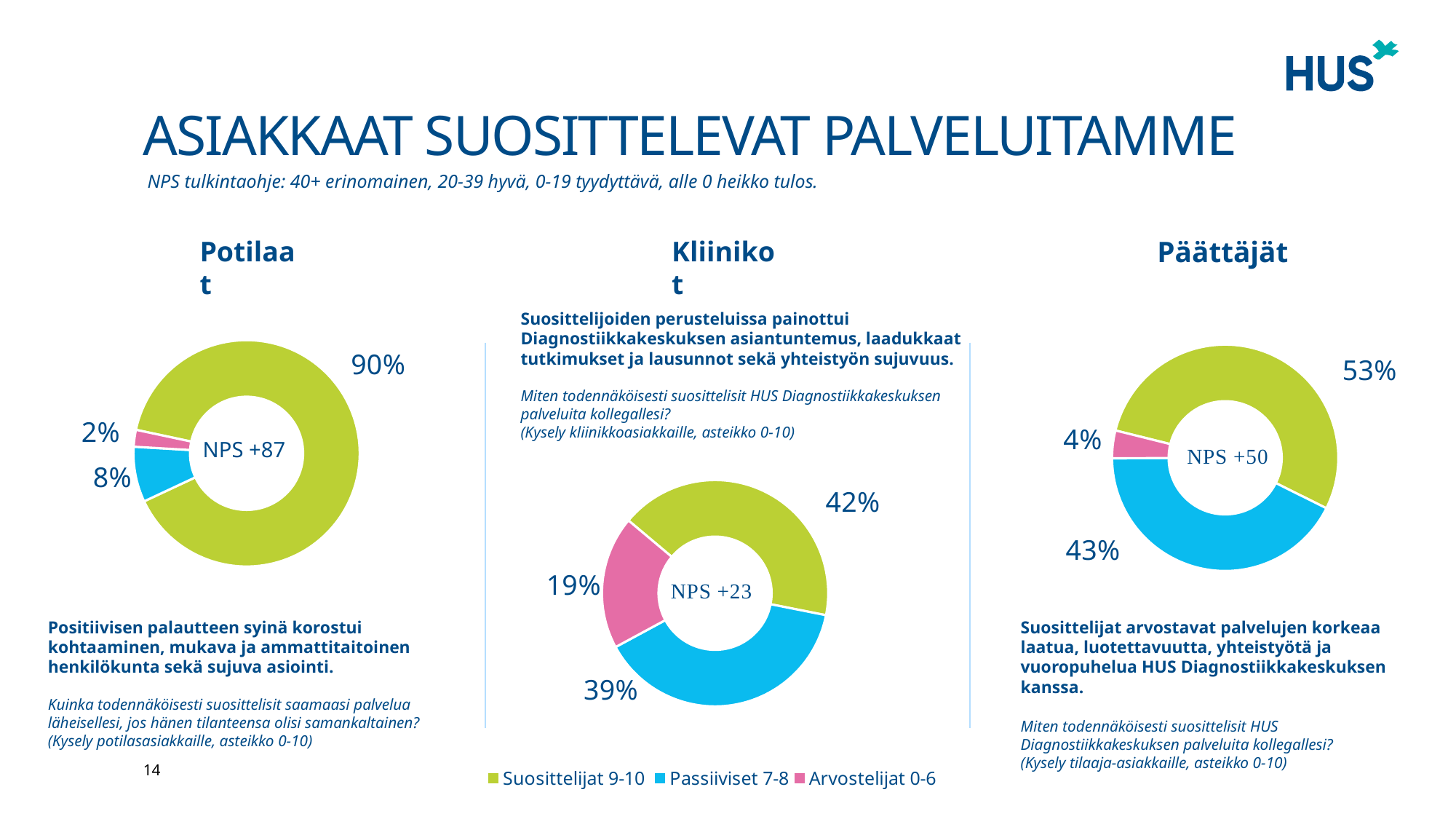
How many categories does the legend at the bottom of the slide list? 3 What NPS value is shown in the centre of the Kliinikot chart? NPS +23 What kind of chart is used for the Potilaat, Kliinikot and Päättäjät data? Donut (pie) chart In the Päättäjät chart, which category has the smallest share? Arvostelijat 0-6 In the Potilaat chart, what share is labelled for Suosittelijat 9-10? 90% In the Kliinikot chart, which category has the largest share? Suosittelijat 9-10 What NPS value is shown in the centre of the Potilaat chart? NPS +87 In the Kliinikot chart, what share is labelled for Passiiviset 7-8? 39% In the Potilaat chart, what share is labelled for Arvostelijat 0-6? 2% In the Päättäjät chart, what share is labelled for Suosittelijat 9-10? 53% In the Kliinikot chart, what share is labelled for Arvostelijat 0-6? 19% In the Päättäjät chart, what is the difference between the Suosittelijat 9-10 share and the Passiiviset 7-8 share? 10%